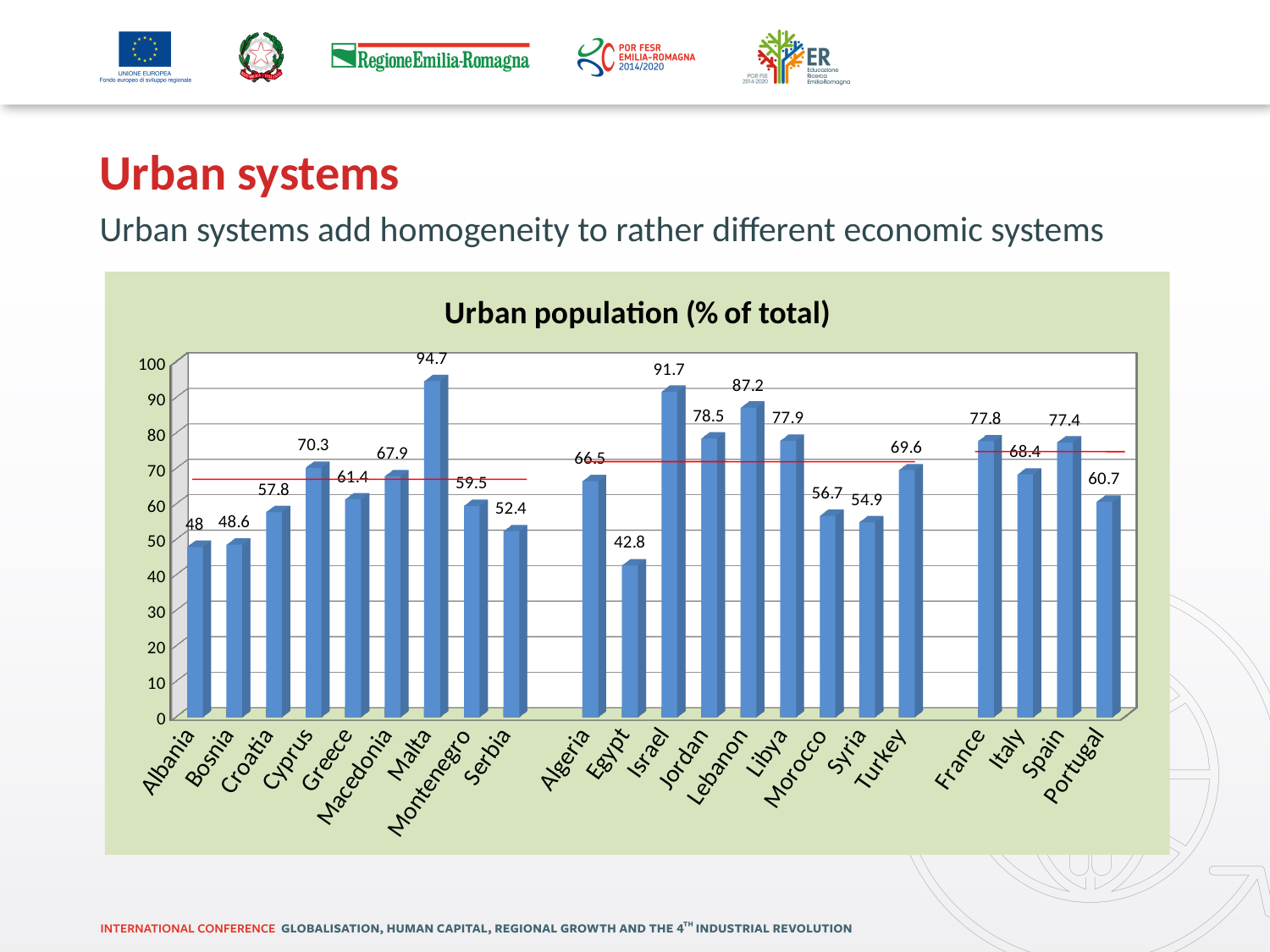
What is the value shown for Portugal? 60.7 What is the value shown for Egypt? 42.8 Which country has the lowest urban population share in the chart? Egypt What type of chart is used to show urban population? Bar chart How many countries are shown in the chart? 22 Which country has the highest urban population share in the chart? Malta What is the title of the chart? Urban population (% of total) What is the urban population value shown for Malta? 94.7 Is the value for Morocco greater or less than 60? less Which has a higher value, Cyprus or Turkey? Cyprus What is the difference between the values for Israel and Jordan? 13.2 What is the value shown for Lebanon? 87.2